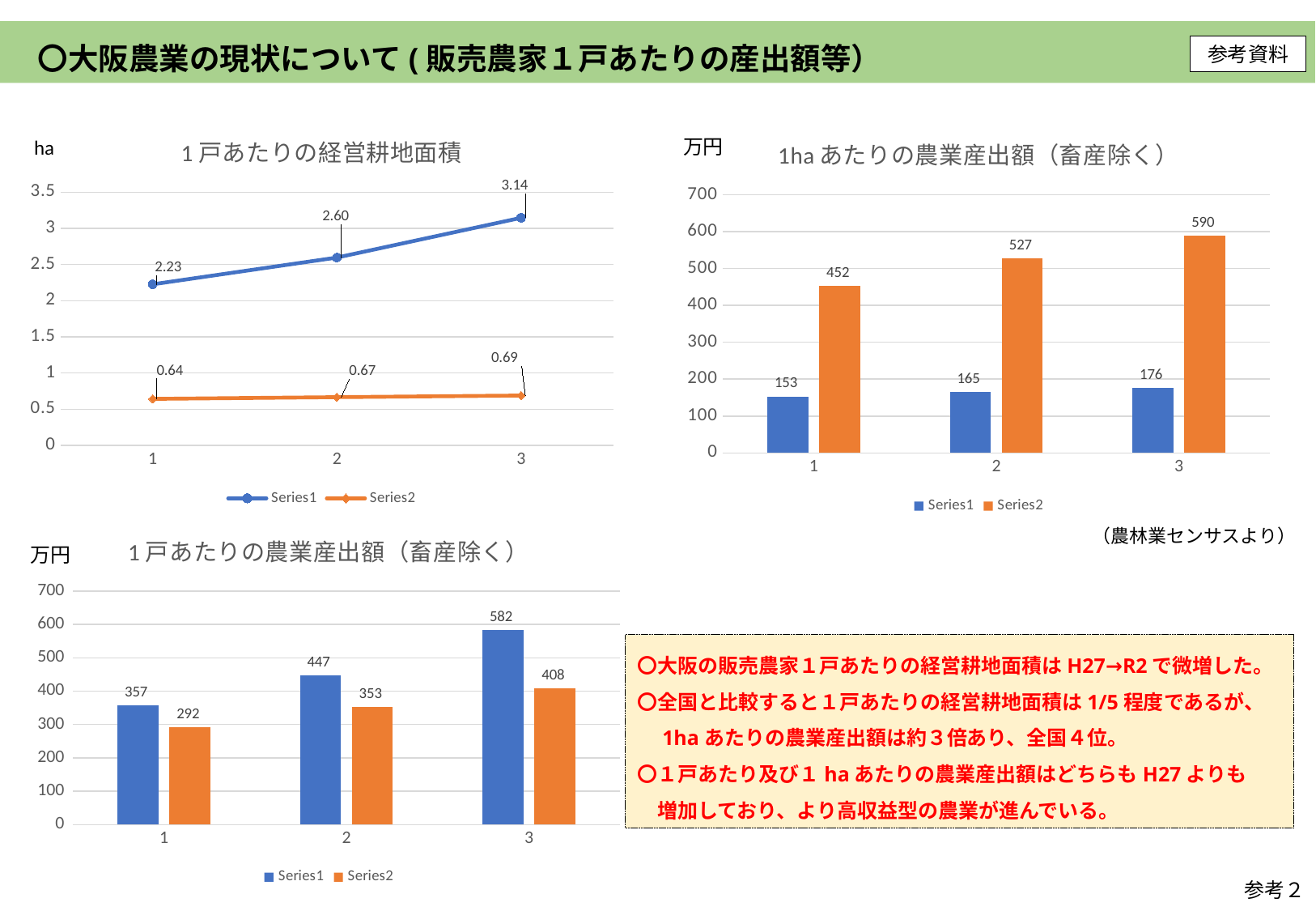
In the chart titled 「1ha あたりの農業産出額（畜産除く）」, what is the difference between Series2 at category 3 and Series2 at category 1? 138 In the chart titled 「１戸あたりの経営耕地面積」, what kind of chart is it? Line chart In the chart titled 「１戸あたりの農業産出額（畜産除く）」, what is the value of Series1 at category 3? 582 In the chart titled 「１戸あたりの経営耕地面積」, do the Series1 values rise or fall from category 1 to category 3? Rise In the chart titled 「１戸あたりの経営耕地面積」, what is the difference between Series1 and Series2 at category 2? 1.93 In the chart titled 「１戸あたりの経営耕地面積」, what is the value of Series1 at category 3? 3.14 In the chart titled 「１戸あたりの経営耕地面積」, what is the value of Series2 at category 1? 0.64 In the chart titled 「1ha あたりの農業産出額（畜産除く）」, how many series does the legend list? 2 In the chart titled 「1ha あたりの農業産出額（畜産除く）」, which category has the lowest Series1 value? 1 In the chart titled 「１戸あたりの農業産出額（畜産除く）」, how many categories are shown on the x axis? 3 In the chart titled 「1ha あたりの農業産出額（畜産除く）」, what is the value of Series2 at category 3? 590 In the chart titled 「１戸あたりの農業産出額（畜産除く）」, which is larger at category 2: Series1 or Series2? Series1